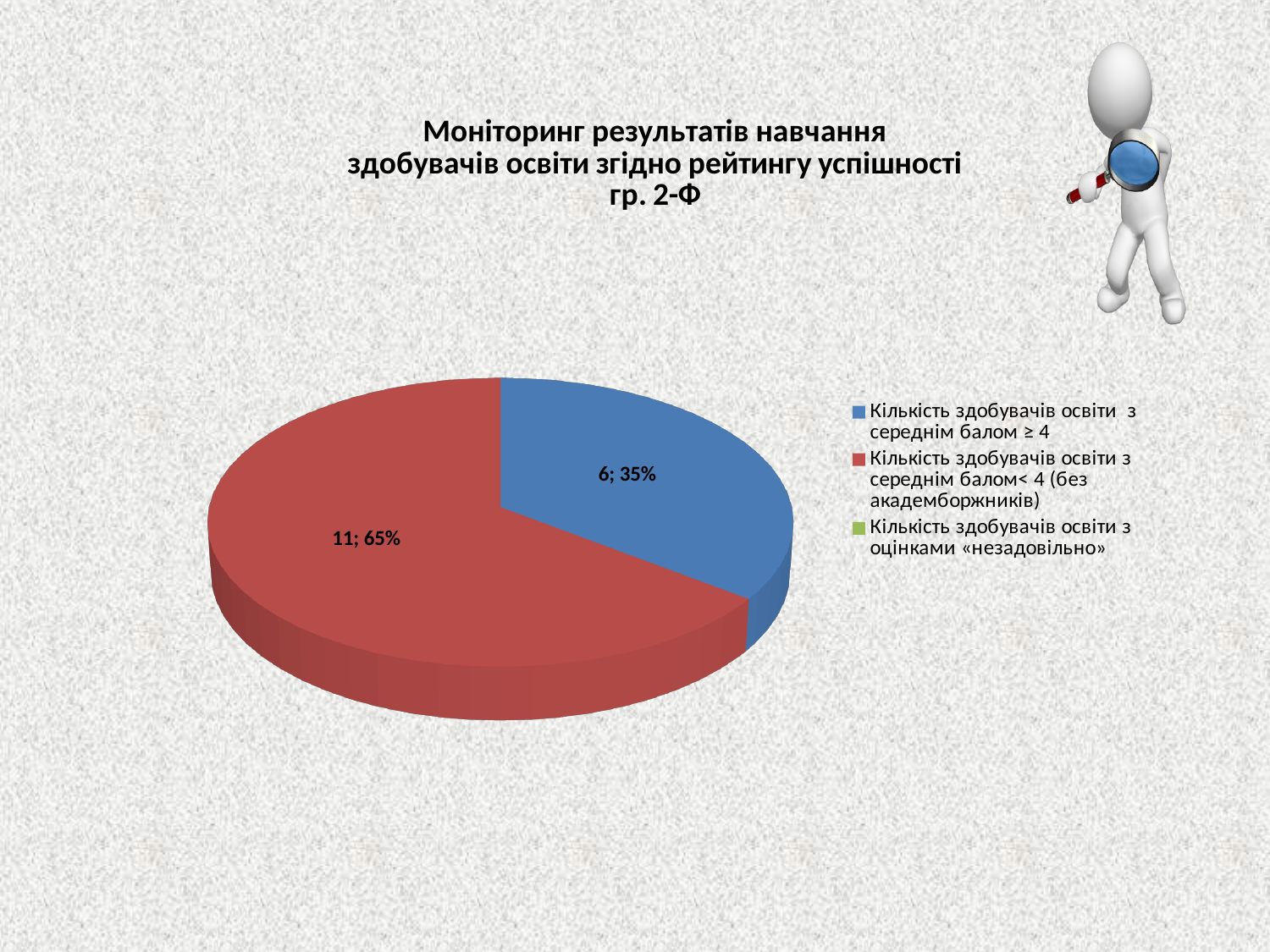
What is the value for 'Кількість здобувачів освіти з середнім балом< 4 (без академборжників)'? 11 Which category has the largest slice in the pie chart? Кількість здобувачів освіти з середнім балом< 4 (без академборжників) Which is larger: the slice for students with an average score ≥ 4 or the slice for students with an average score < 4? students with an average score < 4 How many entries does the legend list? 3 What share of the pie does the slice for students with an average score < 4 represent? 65% What share of the pie does the slice for students with an average score ≥ 4 represent? 35% What is the total number of students represented by the two visible slices? 17 What is the value for 'Кількість здобувачів освіти з середнім балом ≥ 4'? 6 What kind of chart is shown on the slide? pie chart What colour is the slice for students with an average score ≥ 4? blue How many slices are visible in the pie chart? 2 What is the difference between the number of students with an average score < 4 and those with an average score ≥ 4? 5